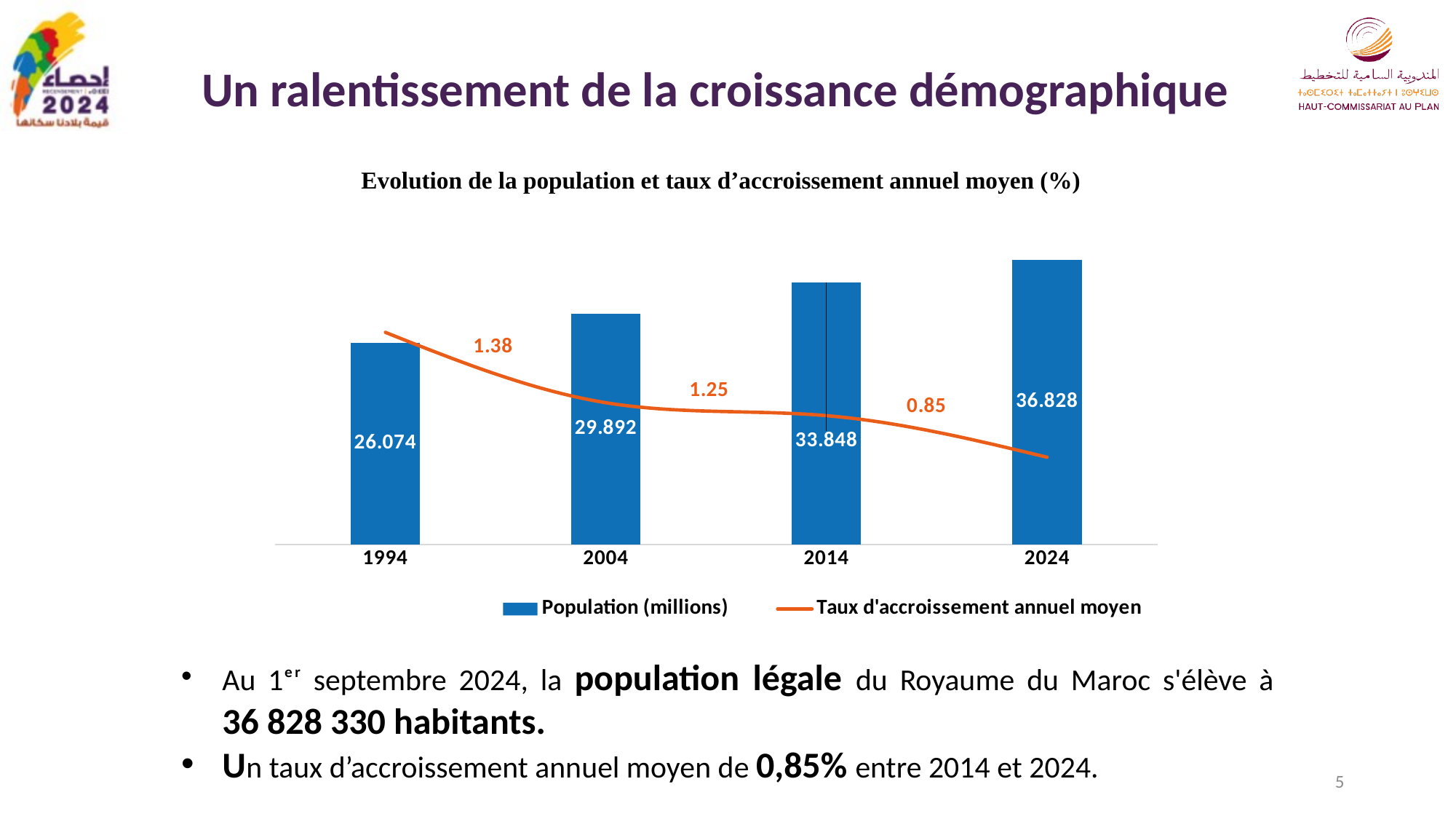
What is the difference between the population values for 2024 and 1994? 10.754 Which year has the highest population bar? 2024 Which year has the lowest population bar? 1994 What is the population (millions) shown for 2014? 33.848 What value of the average annual growth rate is labelled between 1994 and 2004? 1.38 How many years are shown on the x axis? 4 What is the population (millions) shown for 2024? 36.828 Does the average annual growth rate line rise or fall from 1994 to 2024? fall How many series does the legend list? 2 What is the population (millions) shown for 1994? 26.074 What is the difference between the population values for 2014 and 2004? 3.956 What value of the average annual growth rate is labelled between 2014 and 2024? 0.85